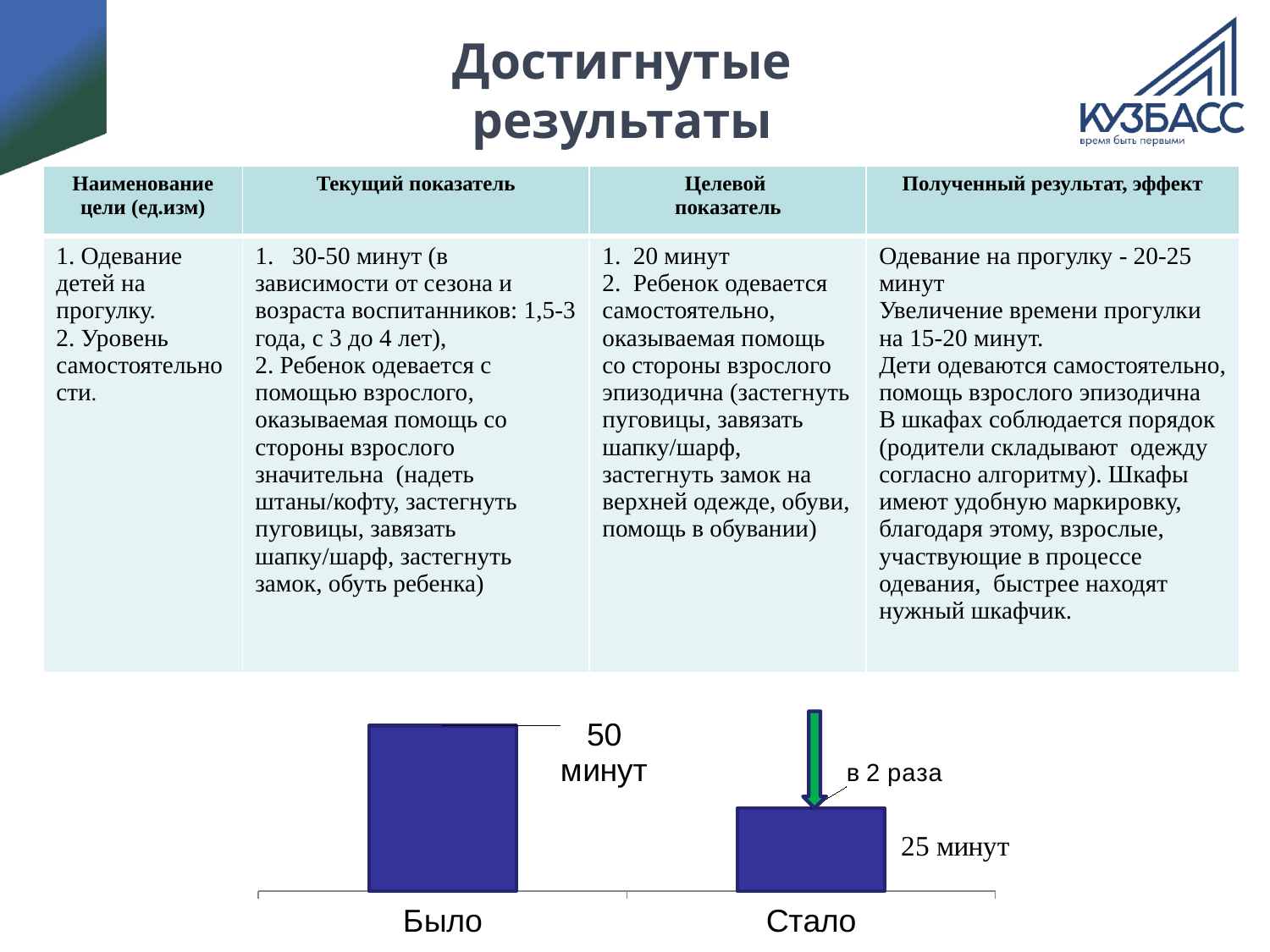
What are the two category labels on the x axis of the chart? Было, Стало How many bars are plotted in the chart? 2 Which is larger in the chart, the value for "Было" or for "Стало"? Было What kind of chart is shown at the bottom of the slide? Bar chart What value is shown for the "Было" bar in the chart? 50 минут Which category has the lowest bar in the chart? Стало What text is written next to the green arrow above the "Стало" bar? в 2 раза Do the values rise or fall from "Было" to "Стало" in the chart? Fall Which category has the highest bar in the chart? Было What is the difference between the "Было" and "Стало" values in the chart? 25 минут What value is shown for the "Стало" bar in the chart? 25 минут